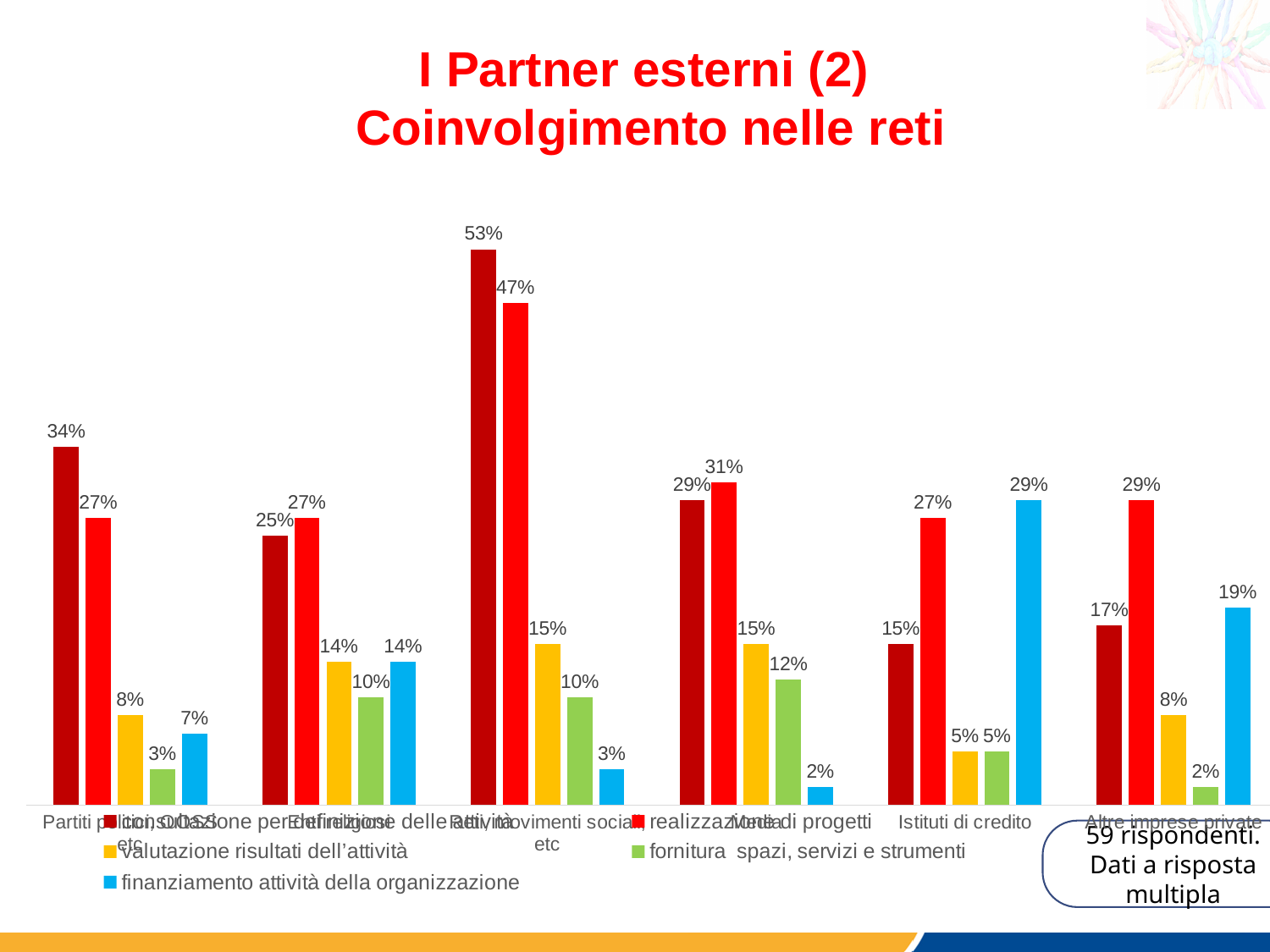
For Altre imprese private, which is larger: the blue bar (finanziamento attività della organizzazione) or the yellow bar (valutazione risultati dell'attività)? the blue bar (finanziamento attività della organizzazione) How many category groups are plotted along the x axis? 6 What is the value of the blue bar (finanziamento attività della organizzazione) for Istituti di credito? 29% Which series is shown in blue in the legend? finanziamento attività della organizzazione For Istituti di credito, what is the difference between the blue bar (29%) and the dark red bar (15%)? 14% What is the value of the yellow bar (valutazione risultati dell'attività) for Istituti di credito? 5% What is the value of the blue bar (finanziamento attività della organizzazione) for Altre imprese private? 19% What is the highest value labelled anywhere on the chart? 53% What is the value of the green bar (fornitura spazi, servizi e strumenti) for Altre imprese private? 2% According to the note on the slide, how many respondents does the data come from? 59 rispondenti How many series does the legend list? 5 What kind of chart is shown on the slide? bar chart